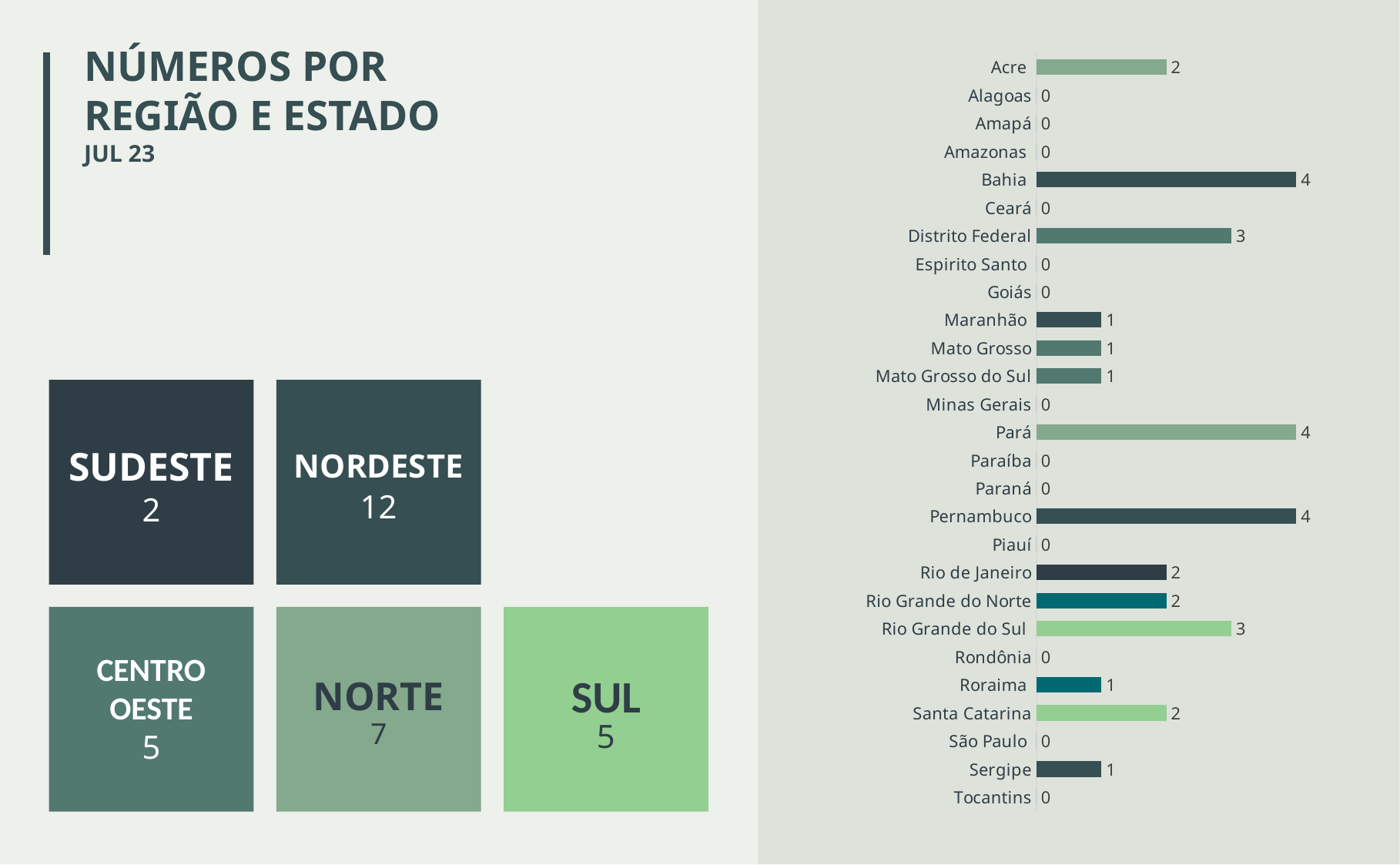
What is the difference between the values for Pará and Acre in the bar chart? 2 What is the value for Bahia in the bar chart? 4 What is the value for Rio Grande do Norte in the bar chart? 2 What is the value for Rio Grande do Sul in the bar chart? 3 What is the highest value shown in the bar chart? 4 What is the value for Sergipe in the bar chart? 1 What kind of chart is shown on the right side of the slide? bar chart Which has a larger value in the bar chart, Rio Grande do Sul or Santa Catarina? Rio Grande do Sul Which states share the highest value in the bar chart? Bahia, Pará, Pernambuco How many states are listed in the bar chart? 27 How many states in the bar chart have a value of 0? 13 What is the value for Distrito Federal in the bar chart? 3